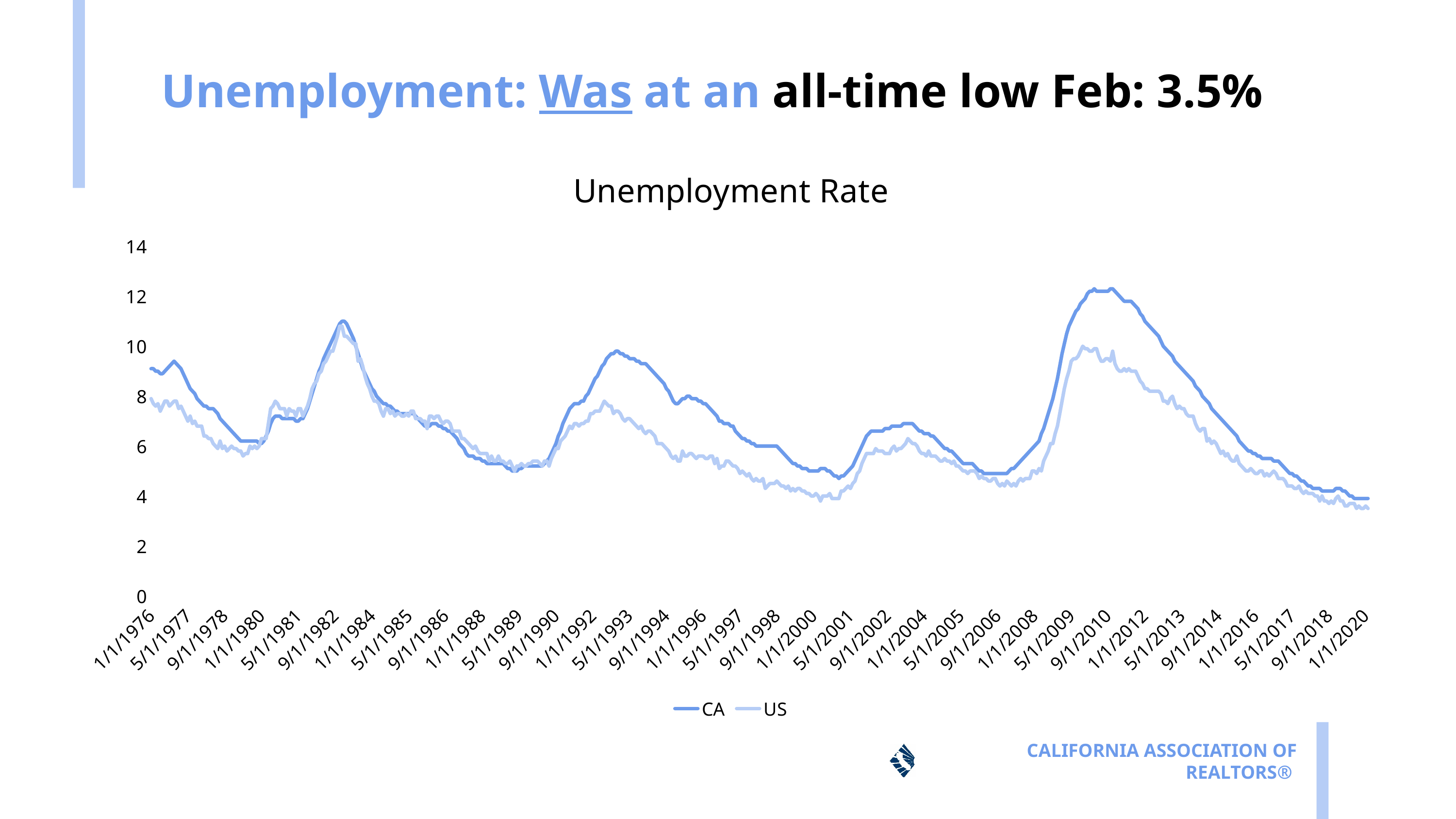
Around 9/1/2010, which series has the higher unemployment rate, CA or US? CA What kind of chart is shown on the slide? line chart What are the two series named in the legend? CA and US Is the CA value around 9/1/2010 greater or less than 10? greater How many series does the legend list? 2 Which series reaches the highest peak on the chart? CA What is the title of the chart? Unemployment Rate Is the CA value around 5/1/1993 greater or less than 8? greater Is the US value around 5/1/1993 greater or less than 6? greater Does the CA line rise or fall between 1/1/2008 and 9/1/2010? rise Does the CA line rise or fall between 9/1/2010 and 1/1/2020? fall